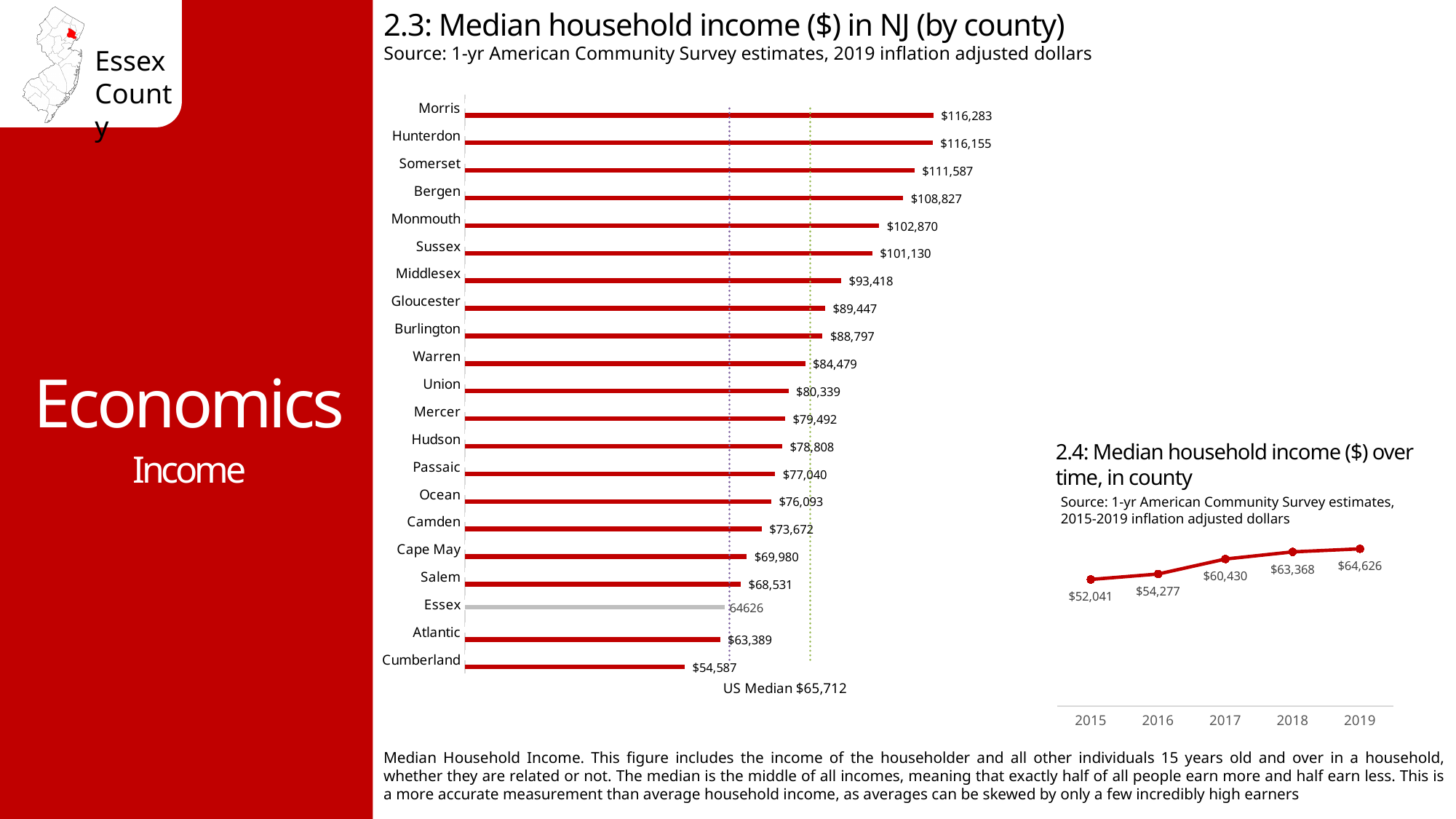
In chart 2.3 (Median household income in NJ by county), which county has the lowest median household income? Cumberland In chart 2.3 (Median household income in NJ by county), which has a higher median household income, Middlesex or Camden? Middlesex In chart 2.4 (Median household income over time, in county), what is the difference between the 2019 and 2015 values? $12,585 What kind of chart is chart 2.3 (Median household income in NJ by county)? Bar chart In chart 2.3 (Median household income in NJ by county), what is the difference between the values for Morris and Cumberland? $61,696 In chart 2.3 (Median household income in NJ by county), how many counties are shown? 21 In chart 2.3 (Median household income in NJ by county), what US Median value is noted on the chart? $65,712 In chart 2.3 (Median household income in NJ by county), what is the value shown for Essex? 64626 In chart 2.4 (Median household income over time, in county), do the values rise or fall from 2015 to 2019? Rise In chart 2.3 (Median household income in NJ by county), which county has the highest median household income? Morris In chart 2.3 (Median household income in NJ by county), what is the median household income for Bergen? $108,827 In chart 2.4 (Median household income over time, in county), what is the value for 2017? $60,430